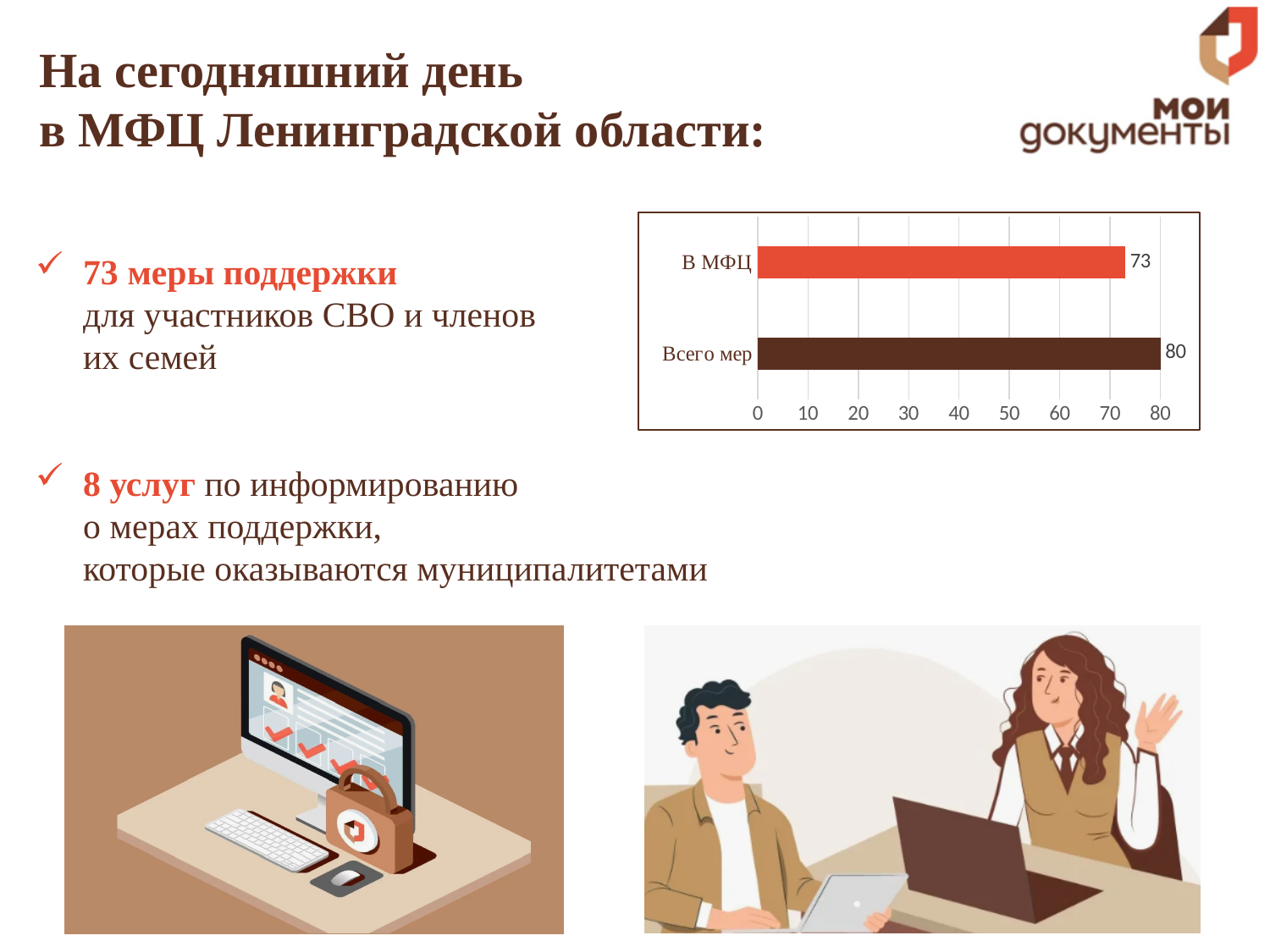
Which category has the lowest value in the chart? В МФЦ Which category has the highest value in the chart? Всего мер What is the value for В МФЦ in the chart? 73 What kind of chart is shown on the slide? bar chart How many categories are shown in the chart? 2 What is the maximum value shown on the chart's horizontal axis? 80 Is the value for В МФЦ greater or less than 70? greater Which is larger: the value for В МФЦ or the value for Всего мер? Всего мер What colour is the bar for В МФЦ? red-orange What is the value for Всего мер in the chart? 80 What is the difference between the values for Всего мер and В МФЦ? 7